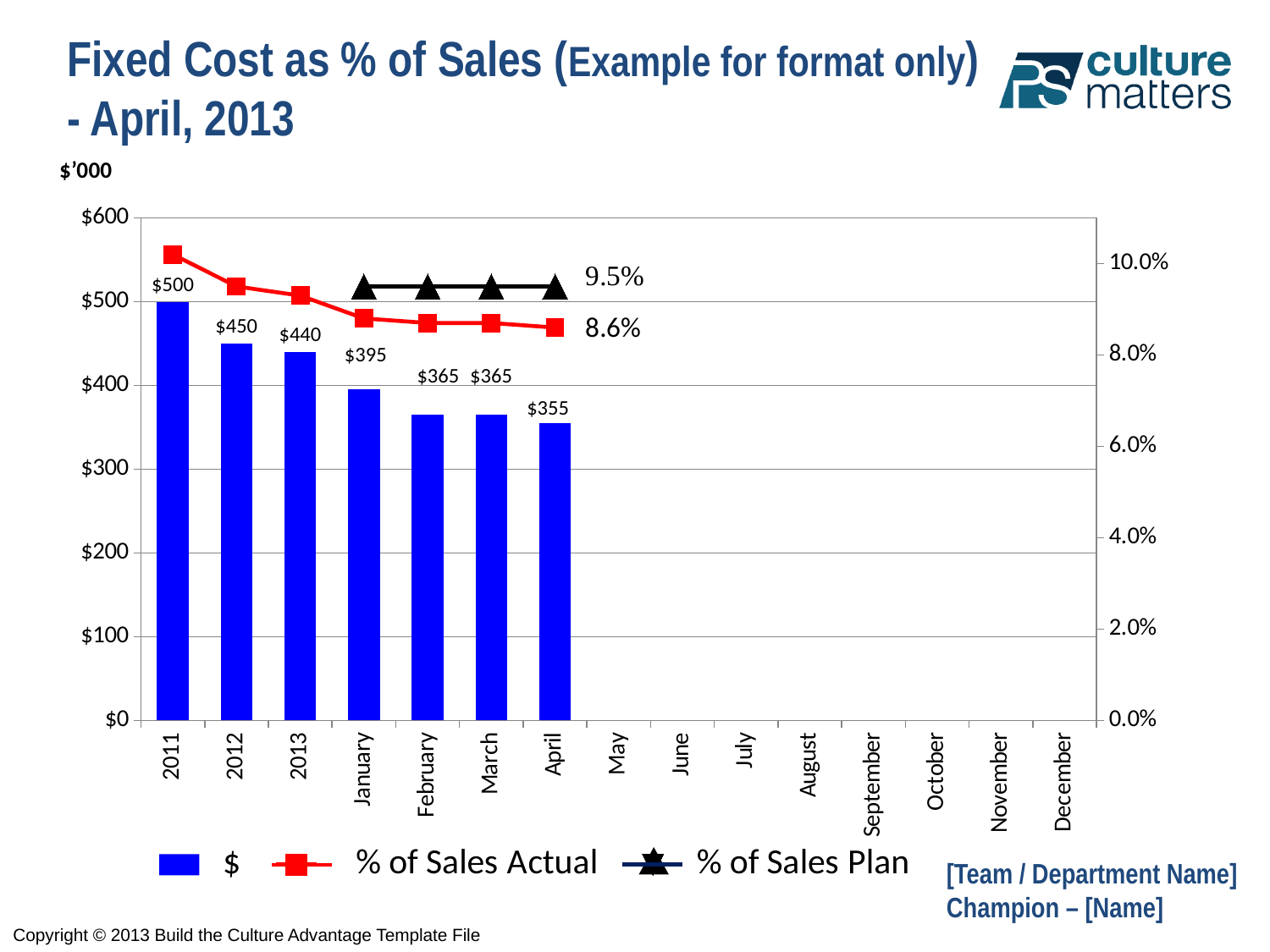
What is the % of Sales Actual value labelled at April? 8.6% What is the $ value for April? $355 What is the $ value for 2011? $500 Which category has the lowest $ bar among those with data? April What is the difference between the $ values for 2011 and April? $145 How many series does the legend list? 3 Do the $ bars rise or fall from 2011 to April? fall What is the $ value for January? $395 Which is larger, the $ value for 2012 or for 2013? 2012 Which category has the highest $ bar? 2011 What is the % of Sales Plan value labelled at April? 9.5% How many categories are shown on the x axis? 15